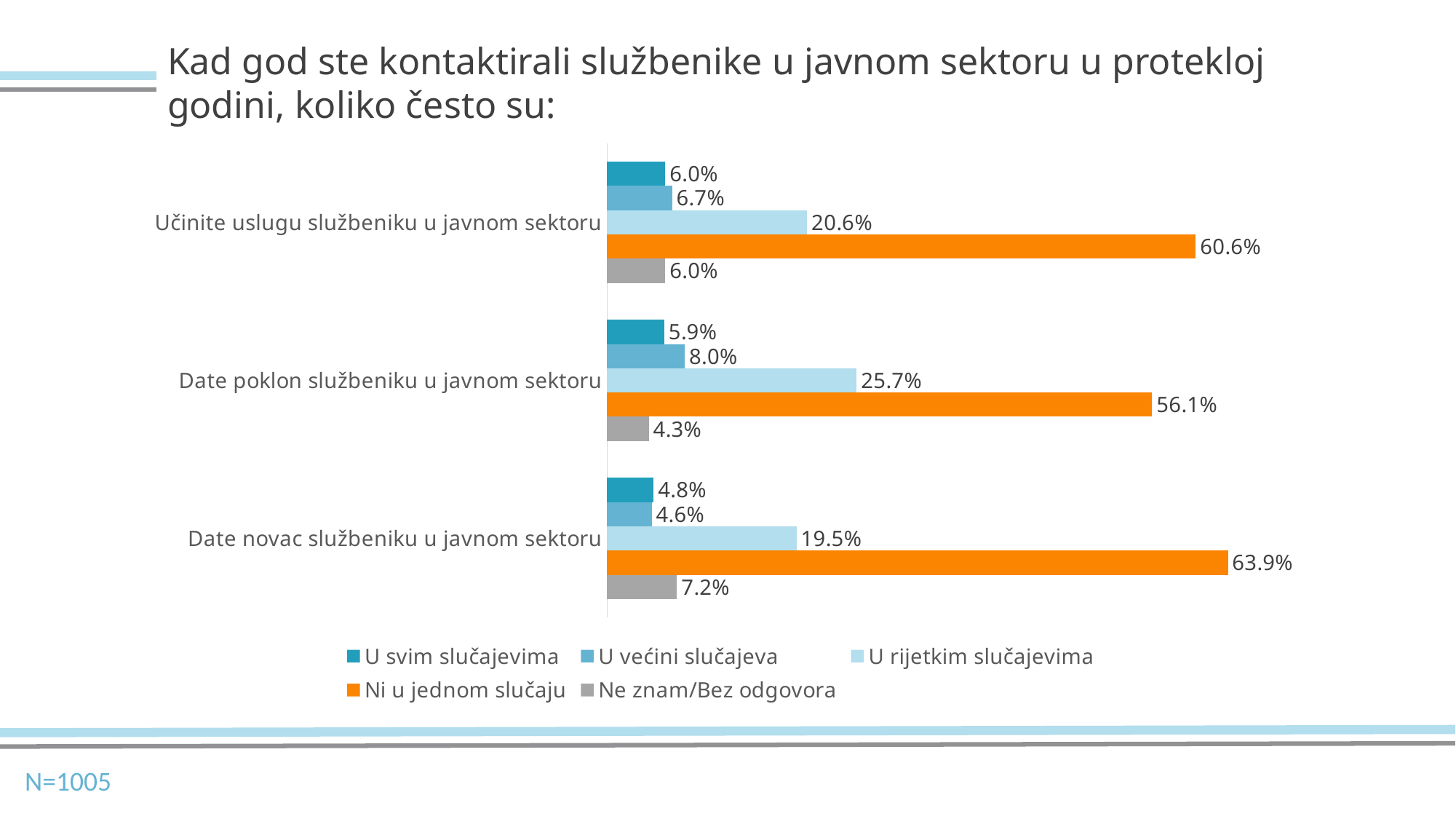
Which category has the lowest value for 'Ne znam/Bez odgovora'? Date poklon službeniku u javnom sektoru What is the difference between the 'Ni u jednom slučaju' values for 'Date novac službeniku u javnom sektoru' and 'Date poklon službeniku u javnom sektoru'? 7.8% How many categories are shown on the chart? 3 What kind of chart is shown on the slide? Bar chart What is the value of 'Ne znam/Bez odgovora' for 'Date novac službeniku u javnom sektoru'? 7.2% Which is larger: 'U rijetkim slučajevima' for 'Date poklon službeniku u javnom sektoru' or for 'Učinite uslugu službeniku u javnom sektoru'? Date poklon službeniku u javnom sektoru How many series does the legend list? 5 What is the value of 'U većini slučajeva' for 'Date poklon službeniku u javnom sektoru'? 8.0% What is the value of 'Ni u jednom slučaju' for 'Učinite uslugu službeniku u javnom sektoru'? 60.6% What is the value of 'U rijetkim slučajevima' for 'Date poklon službeniku u javnom sektoru'? 25.7% Which category has the highest value for 'Ni u jednom slučaju'? Date novac službeniku u javnom sektoru Which series is shown in orange? Ni u jednom slučaju